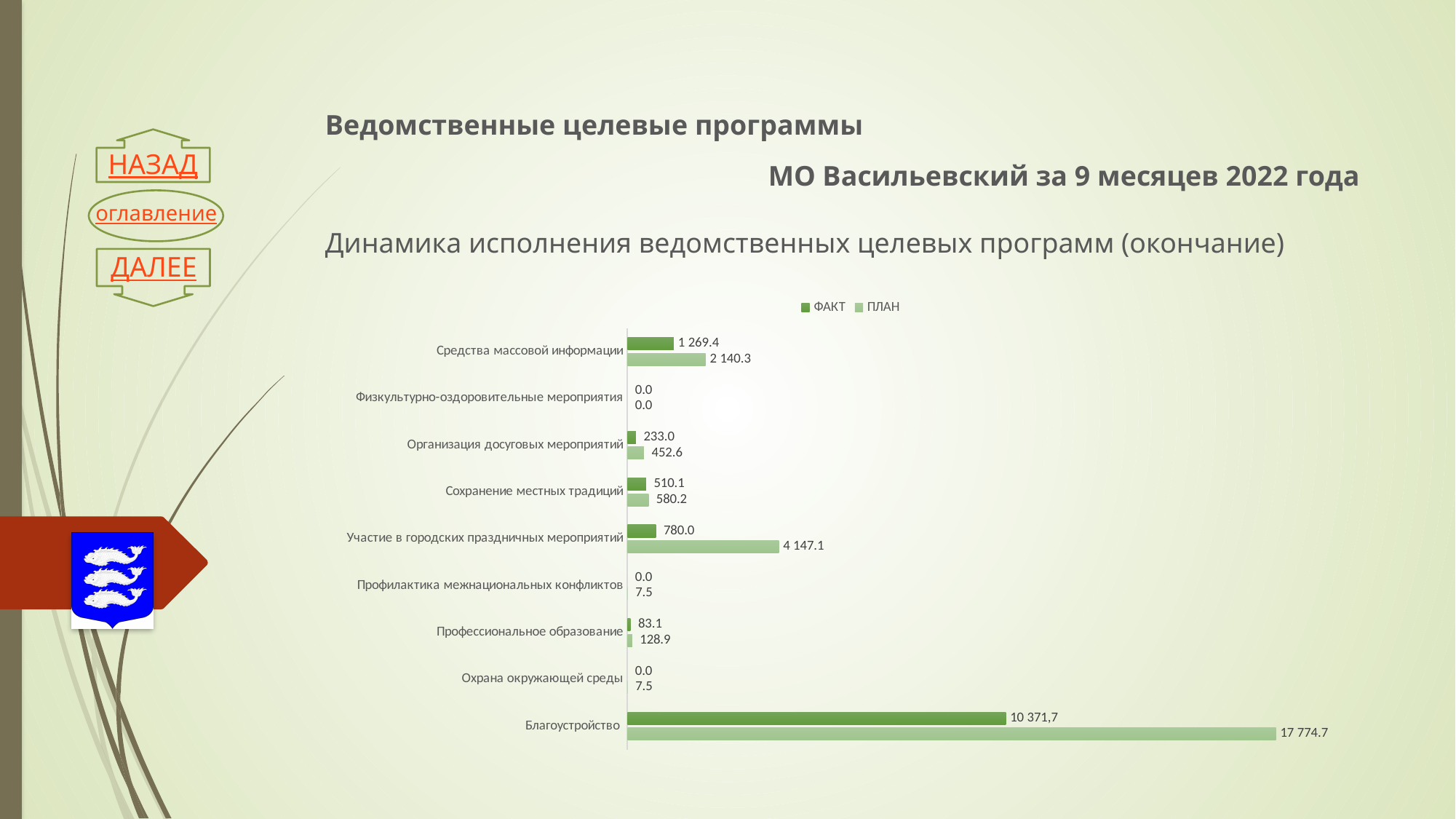
Which category has the highest ПЛАН value? Благоустройство What is the ФАКТ value for Профессиональное образование? 83.1 What is the ПЛАН value for Благоустройство? 17 774.7 How many categories are shown on the chart? 9 What is the difference between the ПЛАН and ФАКТ values for Средства массовой информации? 870.9 Which series is shown in the darker green colour? ФАКТ What is the ПЛАН value for Участие в городских праздничных мероприятий? 4 147.1 Which is larger for Организация досуговых мероприятий, the ФАКТ value or the ПЛАН value? ПЛАН What type of chart is shown on the slide? bar chart How many series does the legend list? 2 What is the ФАКТ value for Средства массовой информации? 1 269.4 What is the difference between the ПЛАН and ФАКТ values for Сохранение местных традиций? 70.1